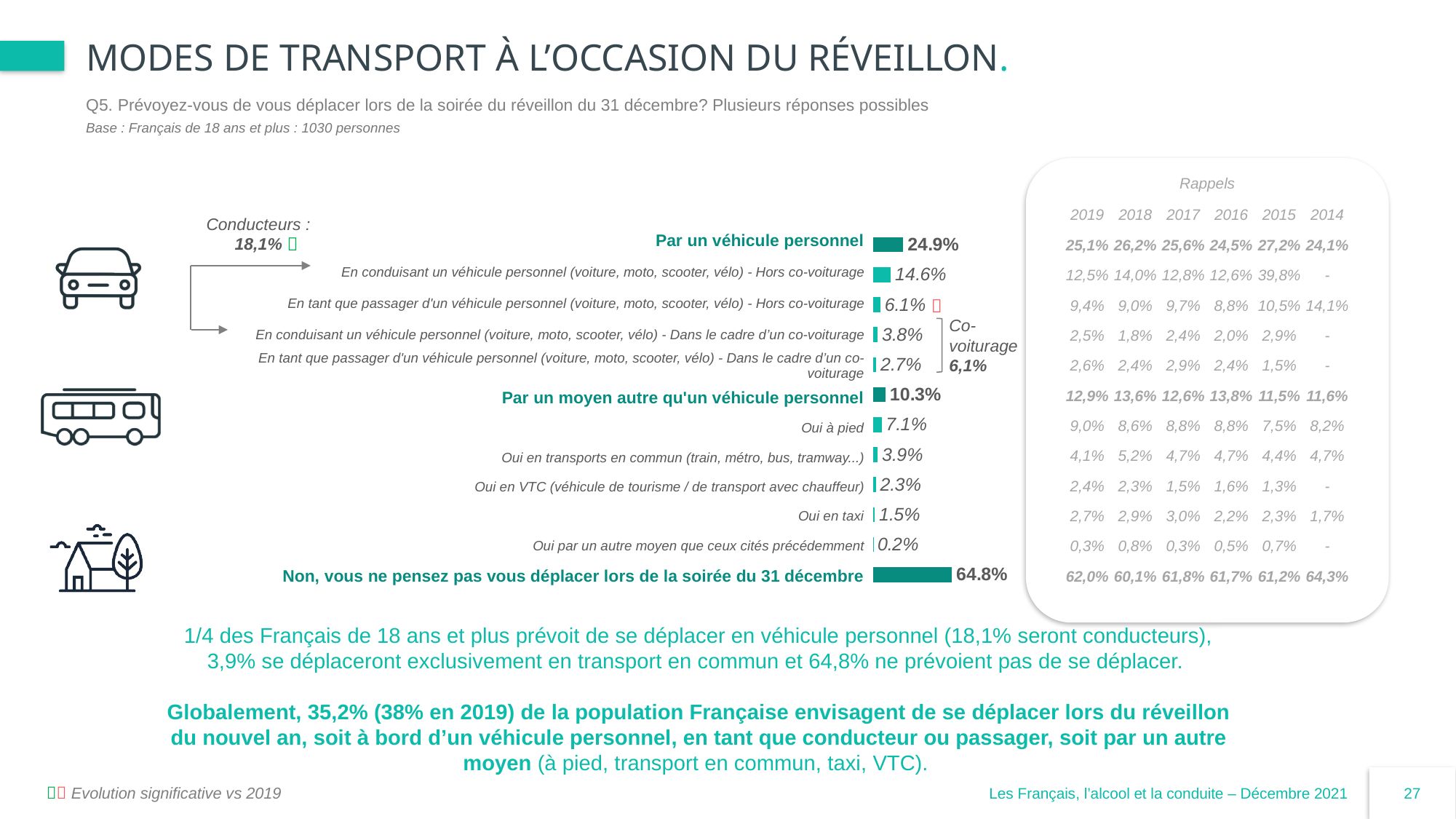
What is the value for "Oui en taxi"? 1.5% What kind of chart is shown on the slide? Bar chart What label and value are shown next to the bracket grouping the two co-voiturage bars? Co-voiturage 6,1% What is the difference between "Par un véhicule personnel" and "Par un moyen autre qu'un véhicule personnel"? 14.6 percentage points What is the value for "Non, vous ne pensez pas vous déplacer lors de la soirée du 31 décembre"? 64.8% What is the value for "Oui à pied"? 7.1% Which is larger: "Oui en VTC (véhicule de tourisme / de transport avec chauffeur)" or "Oui en taxi"? Oui en VTC (véhicule de tourisme / de transport avec chauffeur) Which category has the lowest value? Oui par un autre moyen que ceux cités précédemment How many bars are shown in the chart? 12 Which category has the highest value? Non, vous ne pensez pas vous déplacer lors de la soirée du 31 décembre What is the difference between "Oui à pied" and "Oui en transports en commun (train, métro, bus, tramway...)"? 3.2 percentage points What is the value for "Par un véhicule personnel"? 24.9%